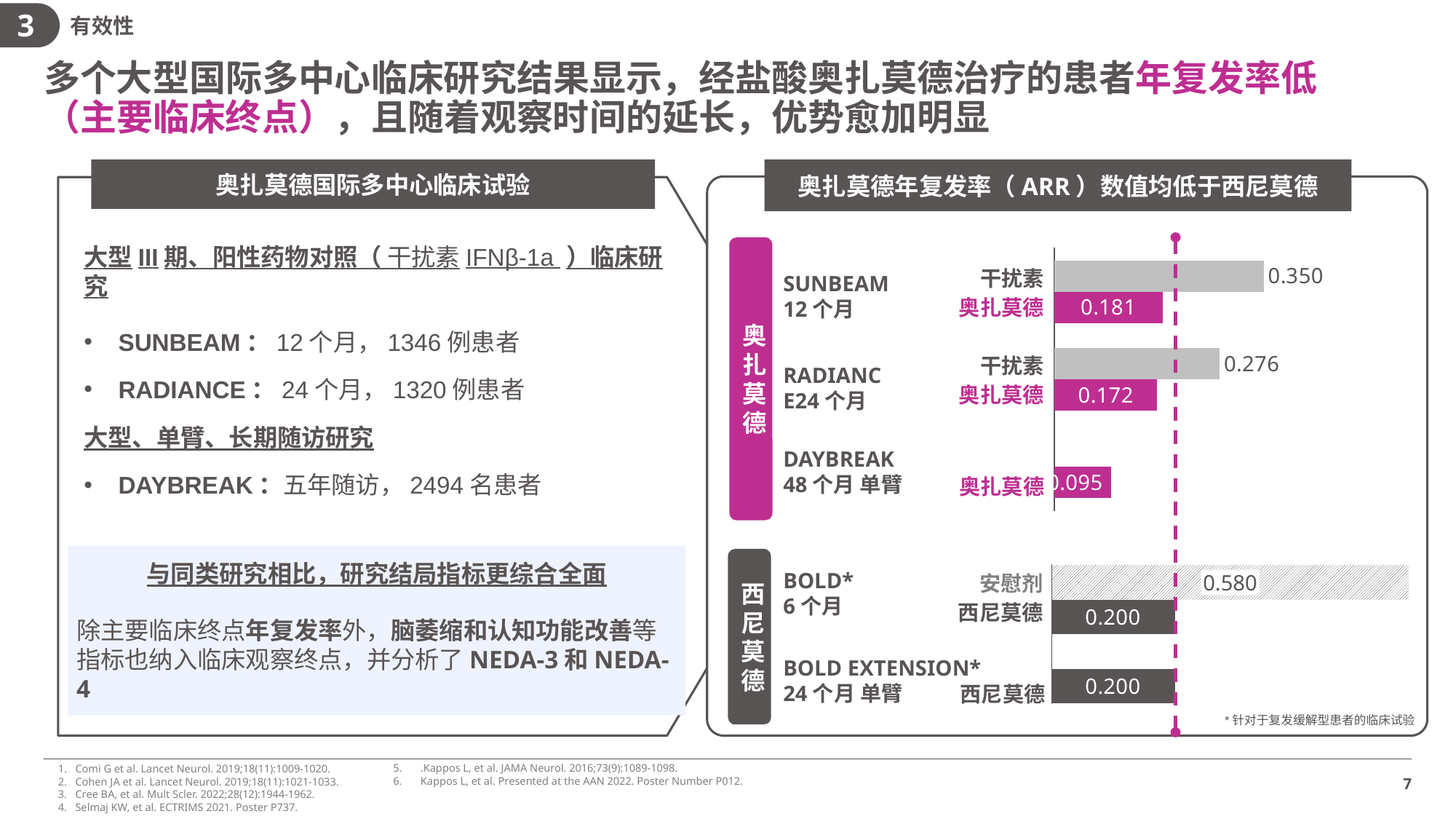
在右侧ARR图中，RADIANCE 24个月研究中奥扎莫德的年复发率是多少？ 0.172 在右侧ARR图中，哪一个条形的数值最高？ BOLD* 6个月 安慰剂（0.580） 在右侧ARR图中，BOLD* 6个月研究中安慰剂的年复发率是多少？ 0.580 在右侧ARR图中，SUNBEAM 12个月研究中干扰素与奥扎莫德的年复发率相差多少？ 0.169 在右侧ARR图中，BOLD EXTENSION* 24个月单臂研究中西尼莫德的年复发率是多少？ 0.200 在右侧ARR图中，RADIANCE 24个月研究中干扰素与奥扎莫德的年复发率相差多少？ 0.104 在右侧ARR图中，SUNBEAM 12个月研究中干扰素的年复发率是多少？ 0.350 在右侧ARR图中，哪一个条形的数值最低？ DAYBREAK 48个月 单臂 奥扎莫德（0.095） 在“奥扎莫德年复发率（ARR）数值均低于西尼莫德”图中，SUNBEAM 12个月研究中奥扎莫德的年复发率是多少？ 0.181 在右侧ARR图中，RADIANCE 24个月的奥扎莫德与BOLD* 6个月的西尼莫德，哪个年复发率更高？ BOLD* 6个月的西尼莫德 右侧“奥扎莫德年复发率（ARR）数值均低于西尼莫德”是什么类型的图表？ 条形图 在右侧ARR图中，DAYBREAK 48个月单臂研究中奥扎莫德的年复发率是多少？ 0.095